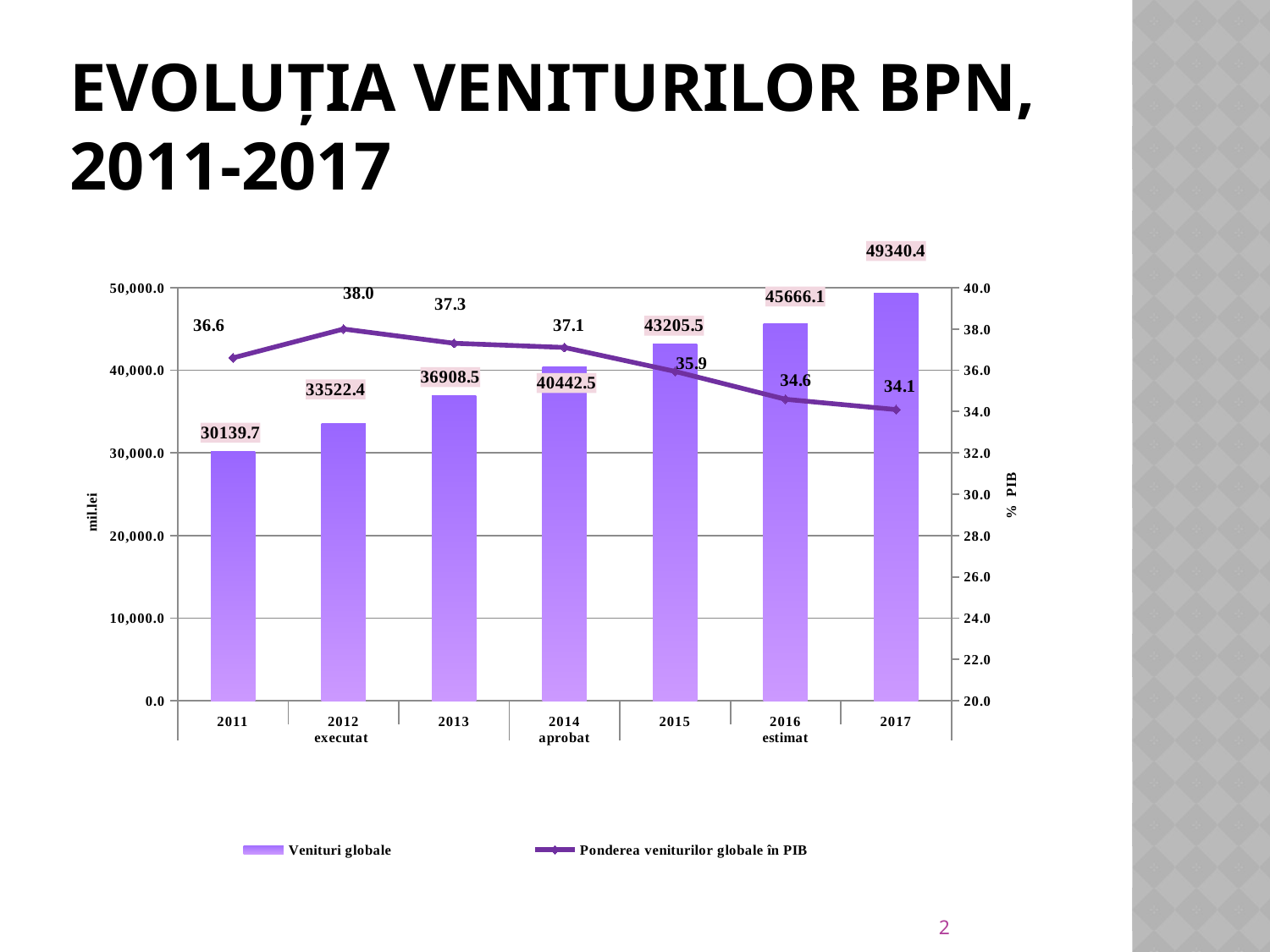
What is the value of Venituri globale for 2017? 49340.4 How many years are shown on the x axis of the chart? 7 Which year has the highest value of Venituri globale? 2017 What is the value of Ponderea veniturilor globale în PIB for 2016 estimat? 34.6 Which is larger, the Ponderea veniturilor globale în PIB value for 2013 or for 2015? 2013 How many series does the legend list? 2 Does the Ponderea veniturilor globale în PIB line rise or fall from 2012 executat to 2017? fall What is the value of Venituri globale for 2011? 30139.7 What is the label of the left vertical axis? mil.lei Which year has the lowest value of Ponderea veniturilor globale în PIB? 2017 What is the value of Ponderea veniturilor globale în PIB for 2012 executat? 38.0 What is the difference between the Venituri globale values for 2015 and 2014 aprobat? 2763.0